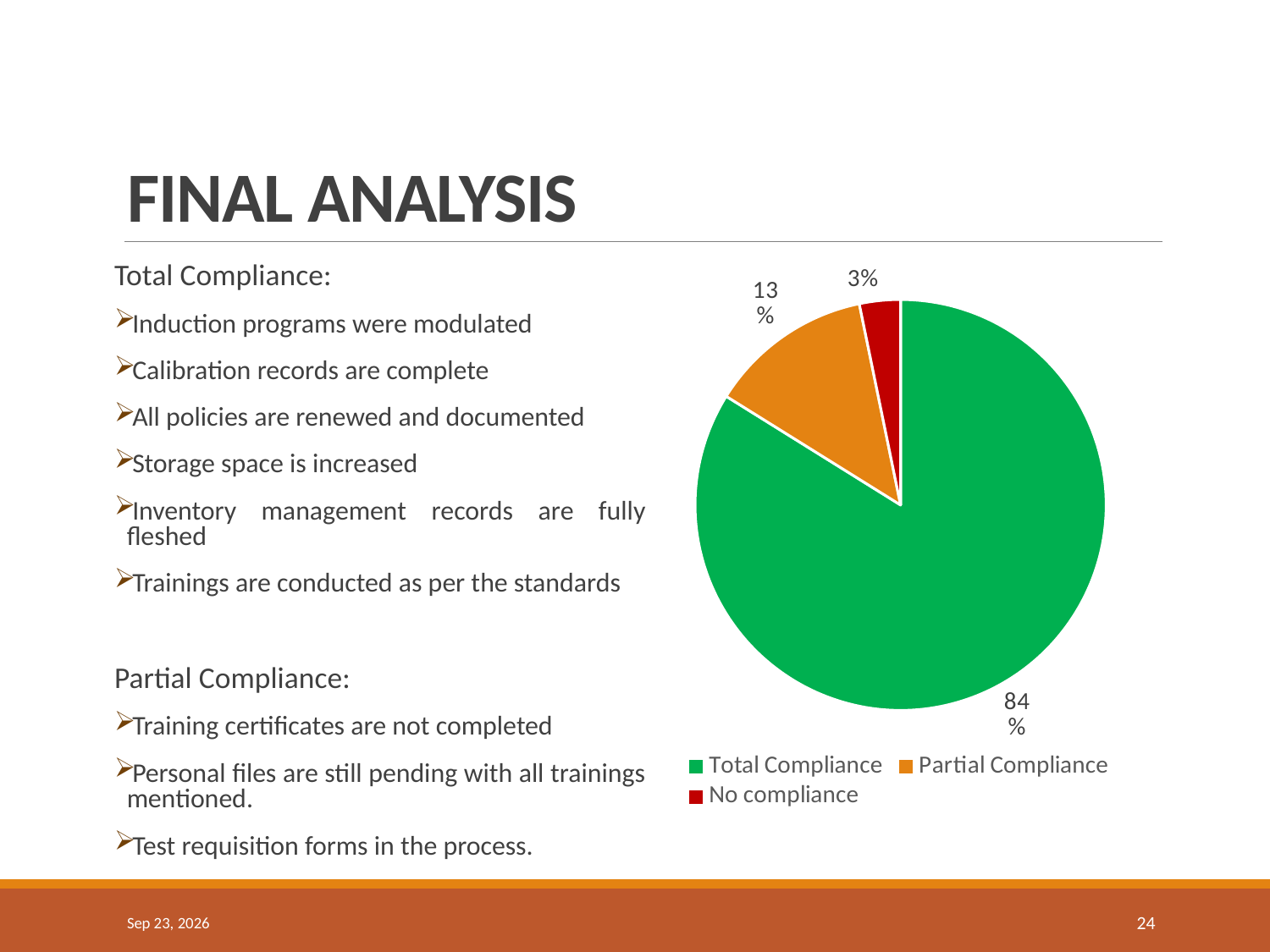
What colour is the Total Compliance slice? green Which category has the largest slice of the pie? Total Compliance What is the difference in percentage points between Total Compliance and Partial Compliance? 71 What share of the pie is Total Compliance? 84% Which is larger, Partial Compliance or No compliance? Partial Compliance What colour is the No compliance slice? red Which category has the smallest slice of the pie? No compliance How many categories does the pie chart have? 3 What share of the pie is No compliance? 3% What is the difference in percentage points between Partial Compliance and No compliance? 10 What kind of chart is shown on the slide? pie chart What share of the pie is Partial Compliance? 13%